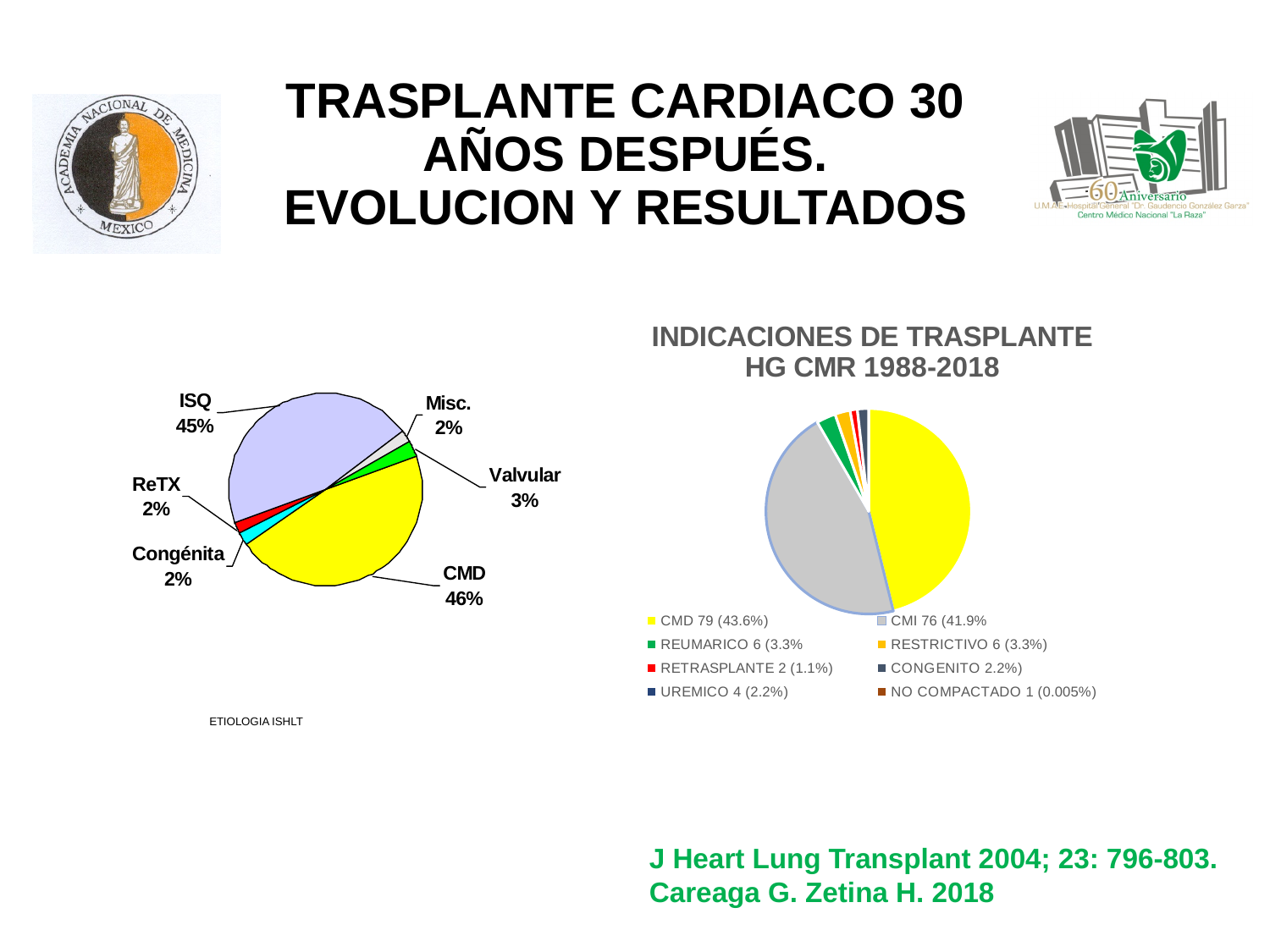
In the chart titled INDICACIONES DE TRASPLANTE HG CMR 1988-2018, how many cases are listed for CMD in the legend? 79 In the left pie chart (ETIOLOGIA ISHLT), which category has the largest share? CMD In the left pie chart (ETIOLOGIA ISHLT), what is the difference between the CMD share and the ISQ share? 1% In the left pie chart (ETIOLOGIA ISHLT), what share does CMD have? 46% In the left pie chart (ETIOLOGIA ISHLT), what share does Valvular have? 3% In the chart titled INDICACIONES DE TRASPLANTE HG CMR 1988-2018, what percentage is shown for CMI in the legend? 41.9% In the left pie chart (ETIOLOGIA ISHLT), how many categories are labelled? 6 What kind of chart is the chart titled INDICACIONES DE TRASPLANTE HG CMR 1988-2018? Pie chart In the chart titled INDICACIONES DE TRASPLANTE HG CMR 1988-2018, how many entries does the legend list? 8 In the chart titled INDICACIONES DE TRASPLANTE HG CMR 1988-2018, which category has the smallest number of cases? NO COMPACTADO In the chart titled INDICACIONES DE TRASPLANTE HG CMR 1988-2018, what is the difference in number of cases between CMD and CMI? 3